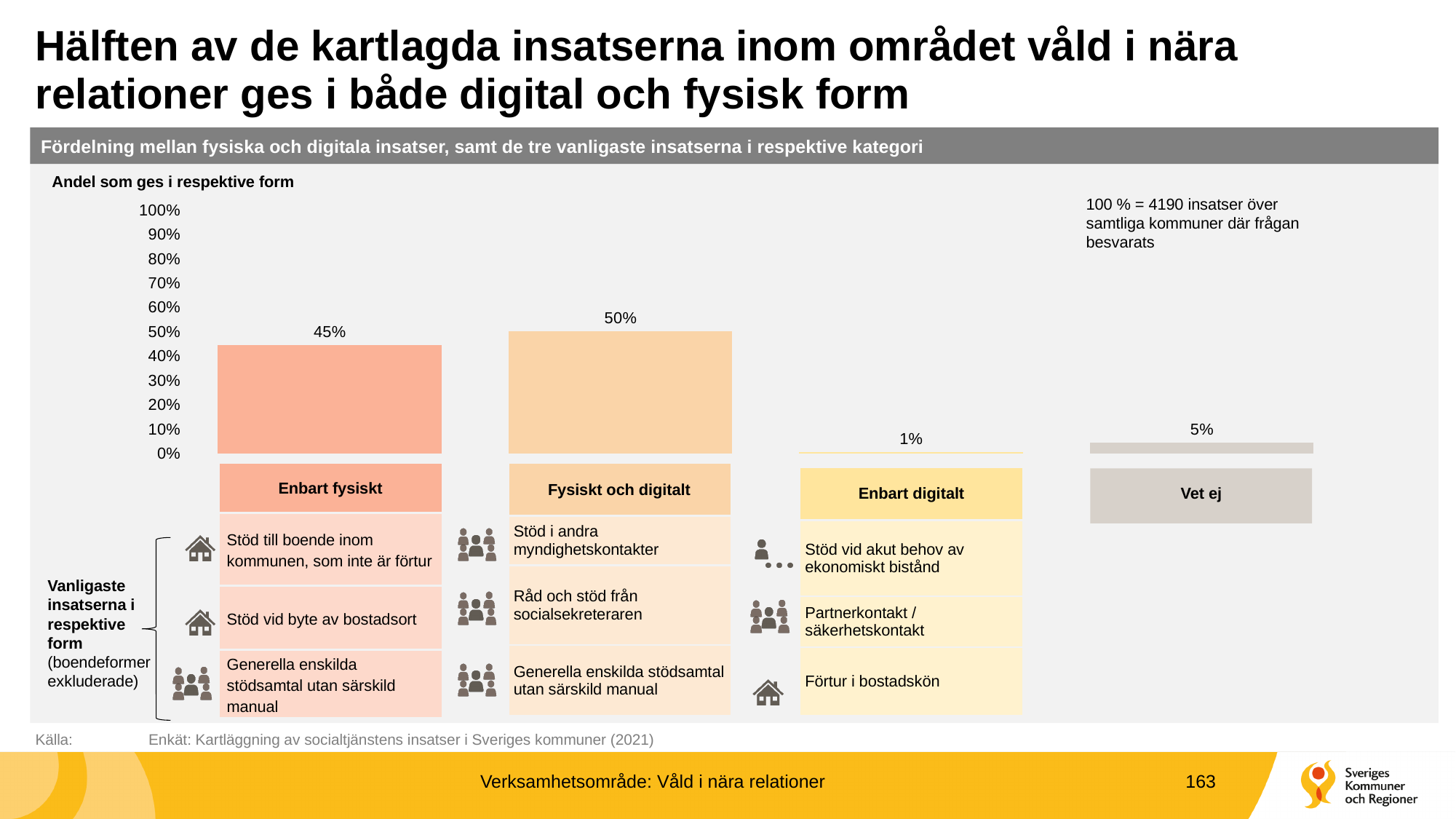
What is the value for Enbart digitalt? 1% What is the value for Fysiskt och digitalt? 50% Is the value for Enbart fysiskt greater or less than 40%? greater Which category has the highest value? Fysiskt och digitalt How many categories are shown in the chart? 4 Which category has the lowest value? Enbart digitalt What is the difference between Fysiskt och digitalt and Enbart fysiskt? 5% What does 100% correspond to according to the note on the chart? 4190 insatser What is the value for Vet ej? 5% What kind of chart is shown? bar chart Which is larger, Vet ej or Enbart digitalt? Vet ej What is the value for Enbart fysiskt? 45%